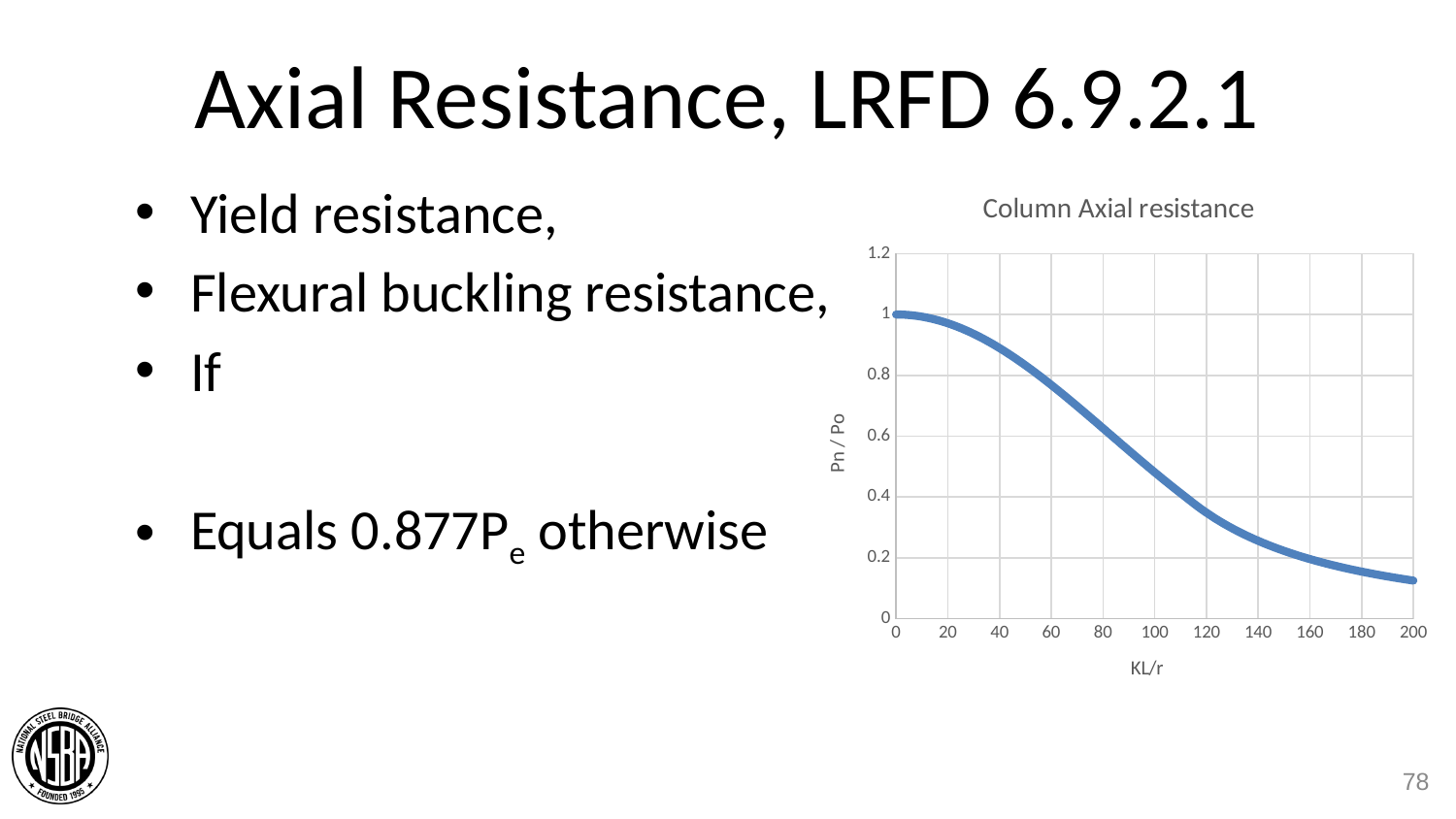
At which KL/r value is Pn / Po lowest? 200 What is the title of the chart? Column Axial resistance Is the value of Pn / Po at KL/r = 120 greater or less than 0.4? less Is the value of Pn / Po at KL/r = 100 greater or less than 0.6? less At which KL/r value is Pn / Po highest? 0 Which is larger, Pn / Po at KL/r = 60 or at KL/r = 160? KL/r = 60 Does Pn / Po rise or fall as KL/r increases along the x axis? fall Is the value of Pn / Po at KL/r = 40 greater or less than 0.8? greater What is the label of the x axis of the chart? KL/r What kind of chart is shown on the slide? line chart